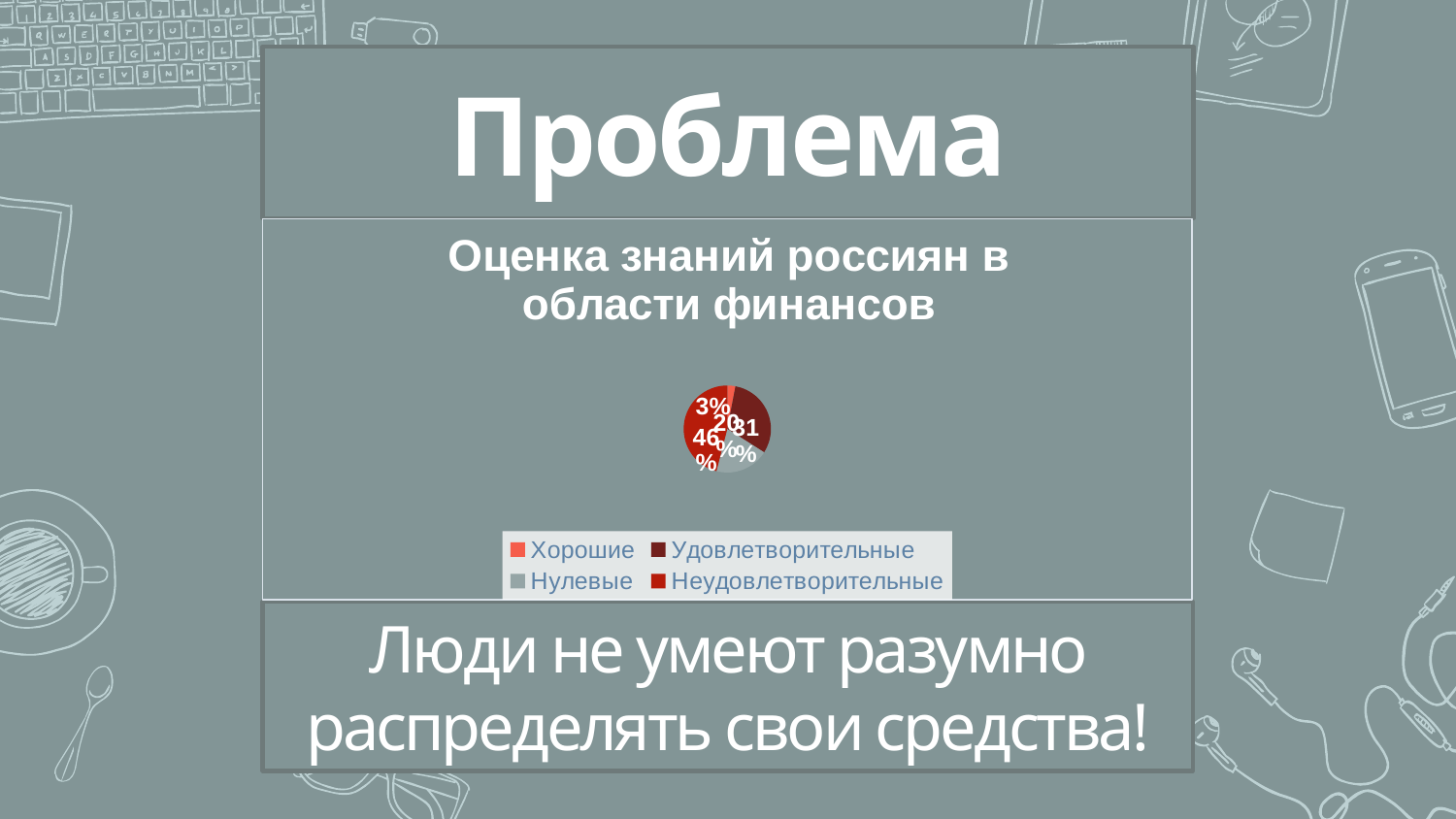
What is the smallest percentage printed on the pie chart? 3% How many entries does the chart's legend list? 4 What is the largest percentage printed on the pie chart? 46% What is the title of the chart on the slide? Оценка знаний россиян в области финансов How many slices does the pie chart have? 4 Which legend entry is listed first in the chart's legend? Хорошие What kind of chart is shown on the slide? pie chart